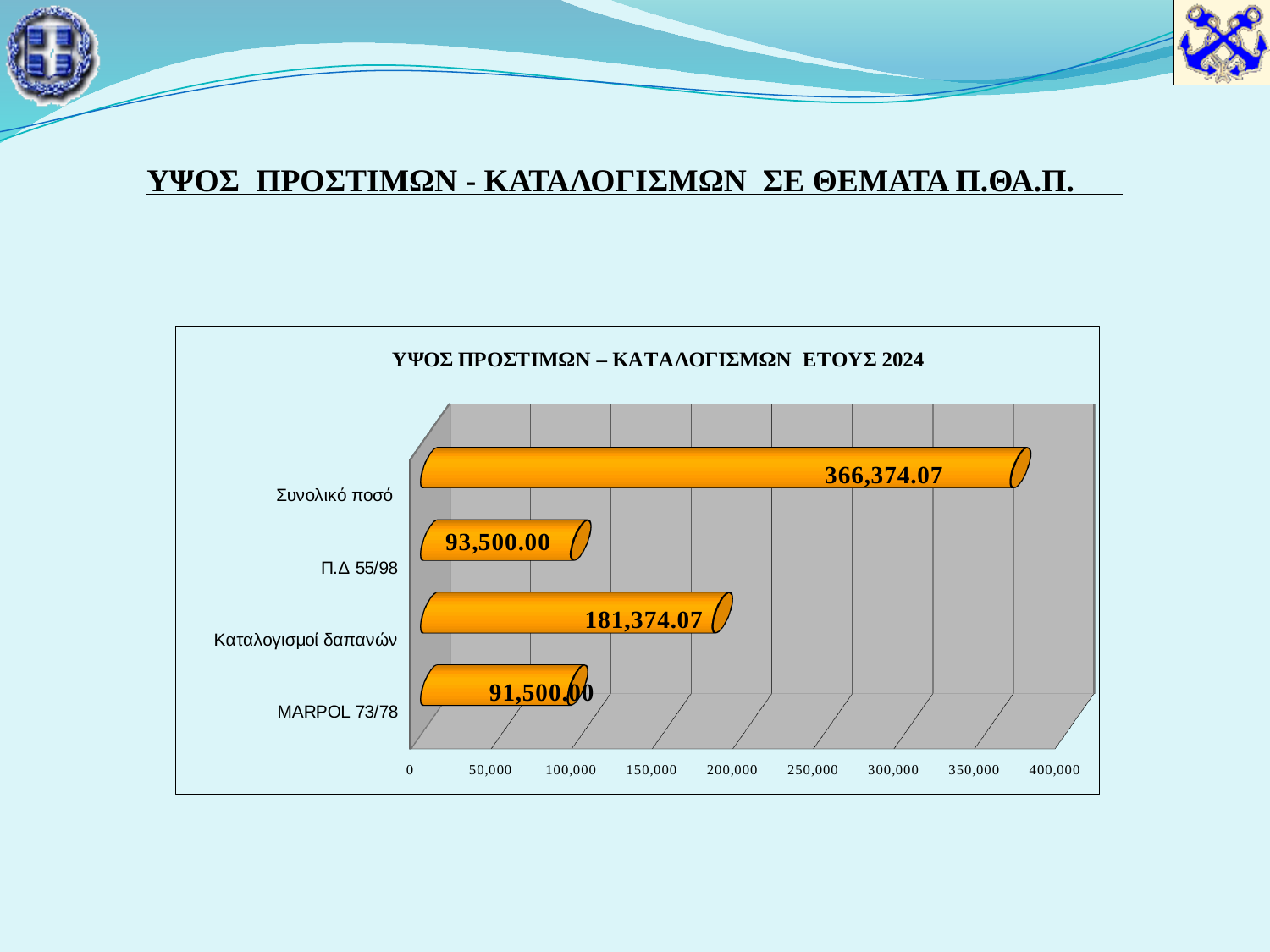
Which category has the lowest value? MARPOL 73/78 What is the difference between the values for Π.Δ 55/98 and MARPOL 73/78? 2,000.00 What is the value for Συνολικό ποσό? 366,374.07 What is the value for Καταλογισμοί δαπανών? 181,374.07 What is the value for MARPOL 73/78? 91,500.00 Which category has the highest value? Συνολικό ποσό How many categories are shown in the chart? 4 What is the value for Π.Δ 55/98? 93,500.00 What is the difference between the values for Καταλογισμοί δαπανών and Π.Δ 55/98? 87,874.07 Which is larger, the value for Καταλογισμοί δαπανών or the value for Π.Δ 55/98? Καταλογισμοί δαπανών Is the value for Καταλογισμοί δαπανών greater or less than 150,000? greater What kind of chart is shown on the slide? bar chart